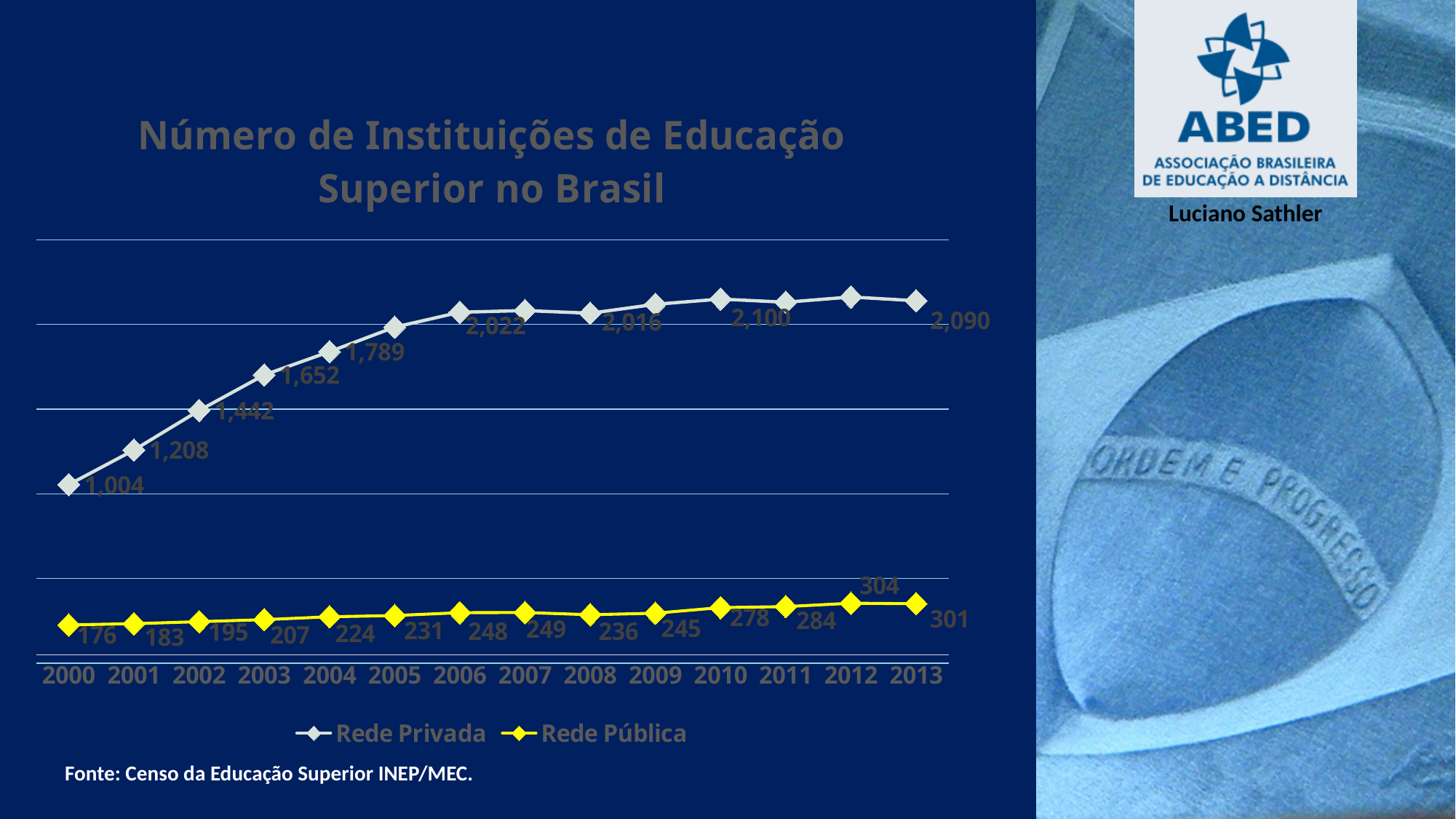
In which year does the Rede Pública series reach its highest value? 2012 Which year has the larger Rede Pública value, 2008 or 2009? 2009 How many series does the legend list? 2 Does the Rede Privada series rise or fall from 2000 to 2006? Rise How many years are shown on the x axis? 14 In which year is the Rede Pública value lowest? 2000 What is the difference between the Rede Privada values in 2010 and 2013? 10 What is the value for Rede Privada in 2013? 2,090 What is the value for Rede Pública in 2012? 304 What kind of chart is shown on the slide? Line chart By how much did Rede Pública increase from 2000 to 2013? 125 What is the value for Rede Privada in 2000? 1,004